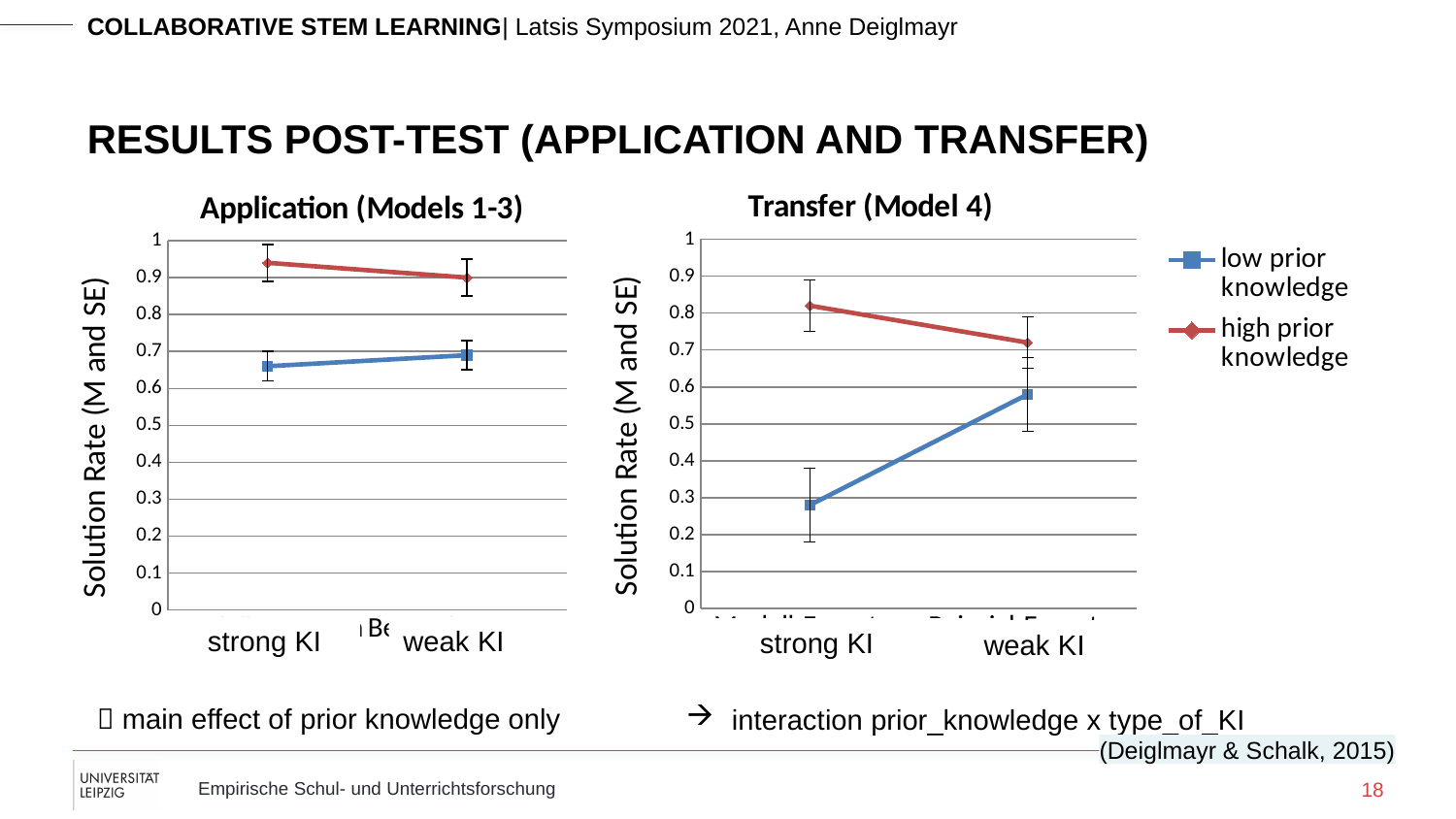
In the Transfer (Model 4) chart, which series and category has the lowest solution rate? low prior knowledge at strong KI What is the y-axis title of the Application (Models 1-3) chart? Solution Rate (M and SE) In the Application (Models 1-3) chart, is the value for low prior knowledge at weak KI greater or less than 0.6? greater How many categories are shown on the x axis of the Transfer (Model 4) chart? 2 In the Transfer (Model 4) chart, is the low prior knowledge value larger at strong KI or at weak KI? weak KI In the Transfer (Model 4) chart, is the value for high prior knowledge at strong KI greater or less than 0.7? greater How many series does the legend list for the charts? 2 In the Transfer (Model 4) chart, is the value for low prior knowledge at strong KI greater or less than 0.4? less In the Transfer (Model 4) chart, does the high prior knowledge line rise or fall from strong KI to weak KI? fall What kind of chart is the Application (Models 1-3) chart? line chart In the Transfer (Model 4) chart, does the low prior knowledge line rise or fall from strong KI to weak KI? rise